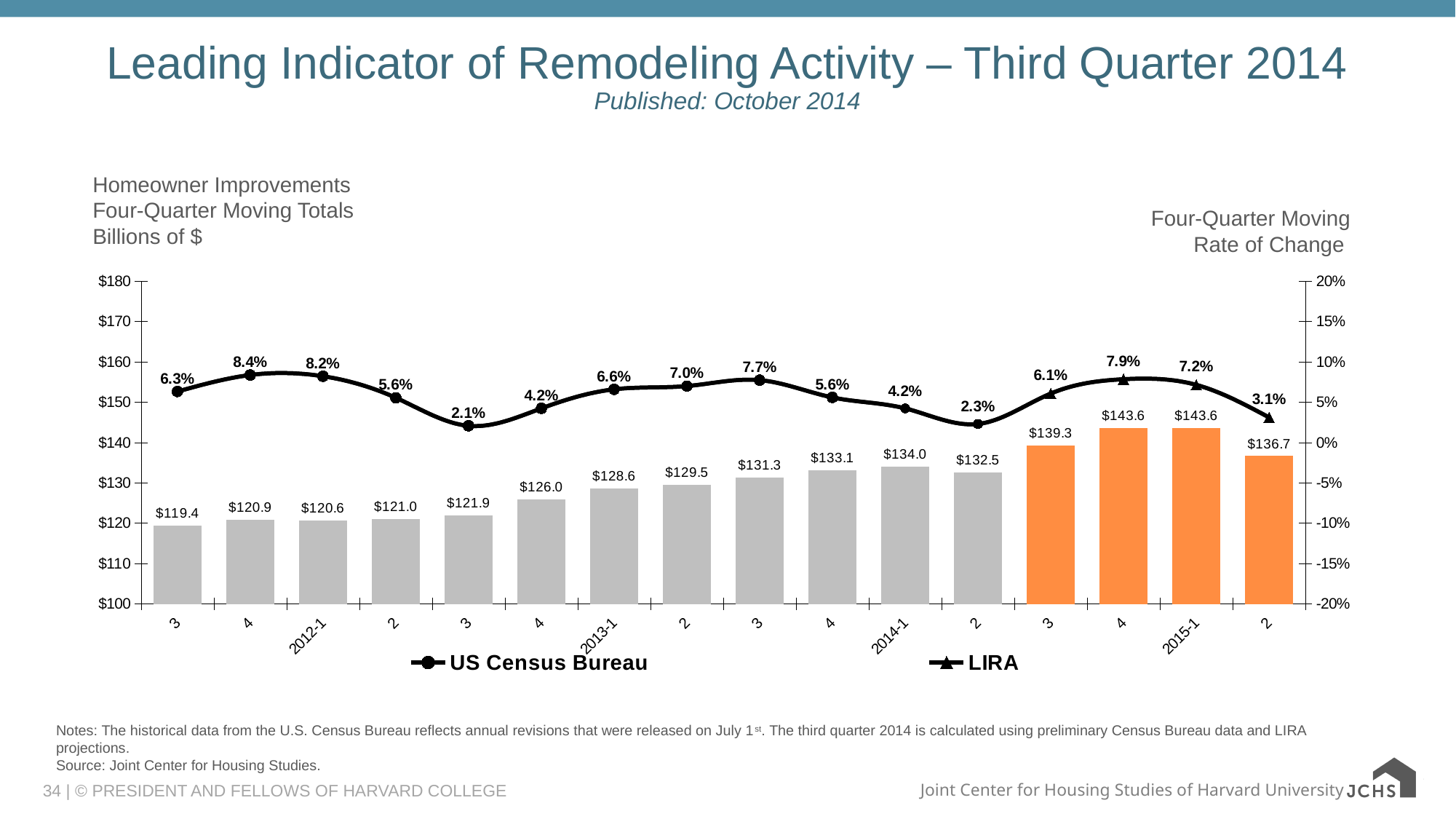
What is the four-quarter moving total for 2014-1? $134.0 What is the difference between the four-quarter moving totals for 2014-1 and 2013-1? $5.4 Do the four-quarter moving totals rise or fall from 2012-1 to 2015-1? Rise Which has the larger four-quarter moving total, 2015-1 or 2014-1? 2015-1 What is the lowest four-quarter moving rate of change shown on the line? 2.1% What kind of chart is shown? Combined bar and line chart What is the four-quarter moving total for 2015-1? $143.6 What is the highest four-quarter moving rate of change shown on the line? 8.4% How many series does the legend list? 2 What is the four-quarter moving rate of change for 2013-1? 6.6% How many bars are plotted on the chart? 16 What is the lowest four-quarter moving total shown by the bars? $119.4